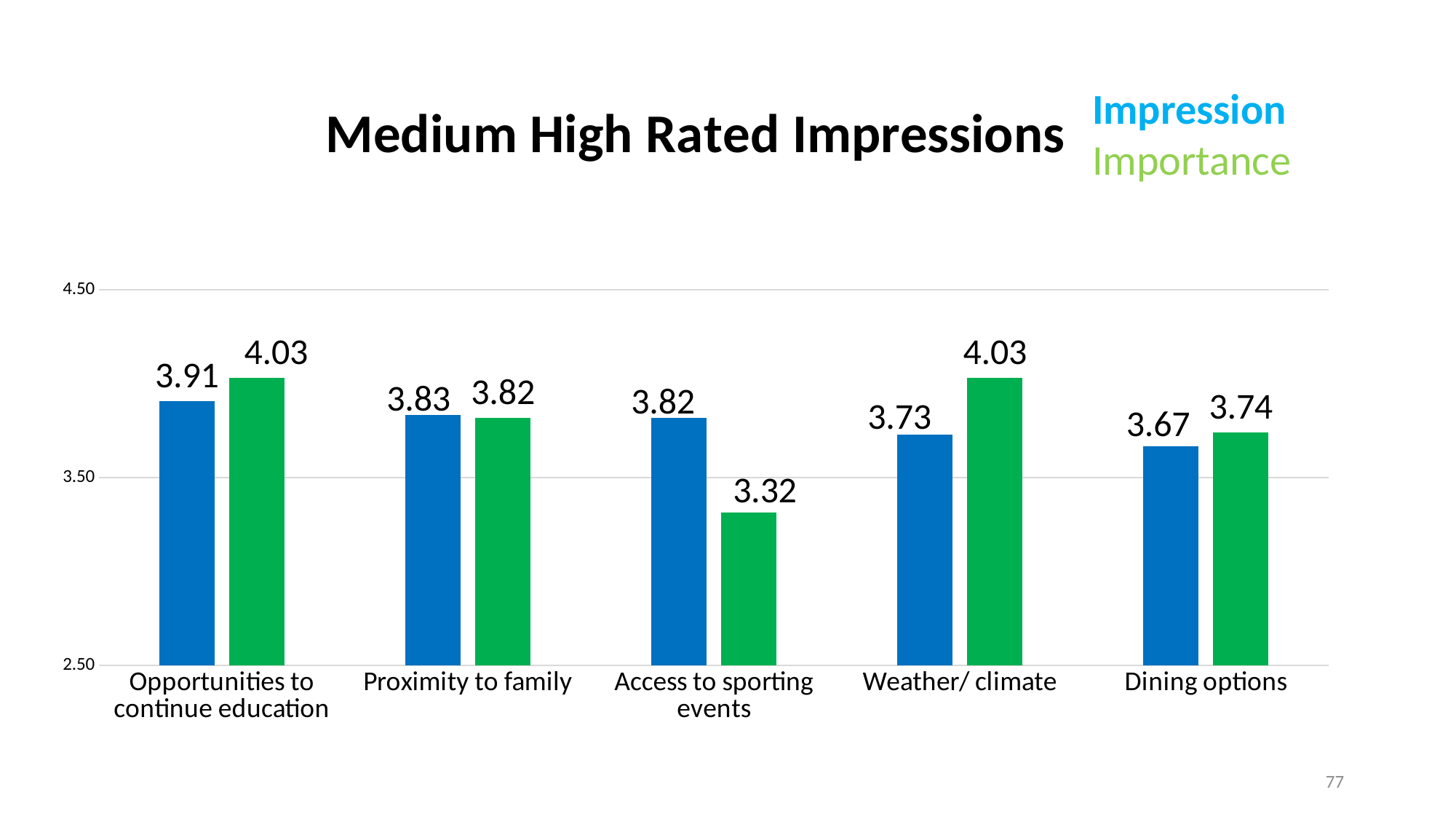
How many categories are shown on the x axis? 5 Which category has the lowest Importance value? Access to sporting events For Weather/ climate, which is larger: the Impression value or the Importance value? Importance What is the difference between the Importance values for Weather/ climate and Dining options? 0.29 What is the difference between the Impression and Importance values for Access to sporting events? 0.50 What is the Importance value for Access to sporting events? 3.32 What is the Impression value for Proximity to family? 3.83 Is the Importance value for Access to sporting events greater or less than 3.50? less How many series does the legend list? 2 What kind of chart is shown on the slide? bar chart Which category has the lowest Impression value? Dining options What is the Importance value for Dining options? 3.74